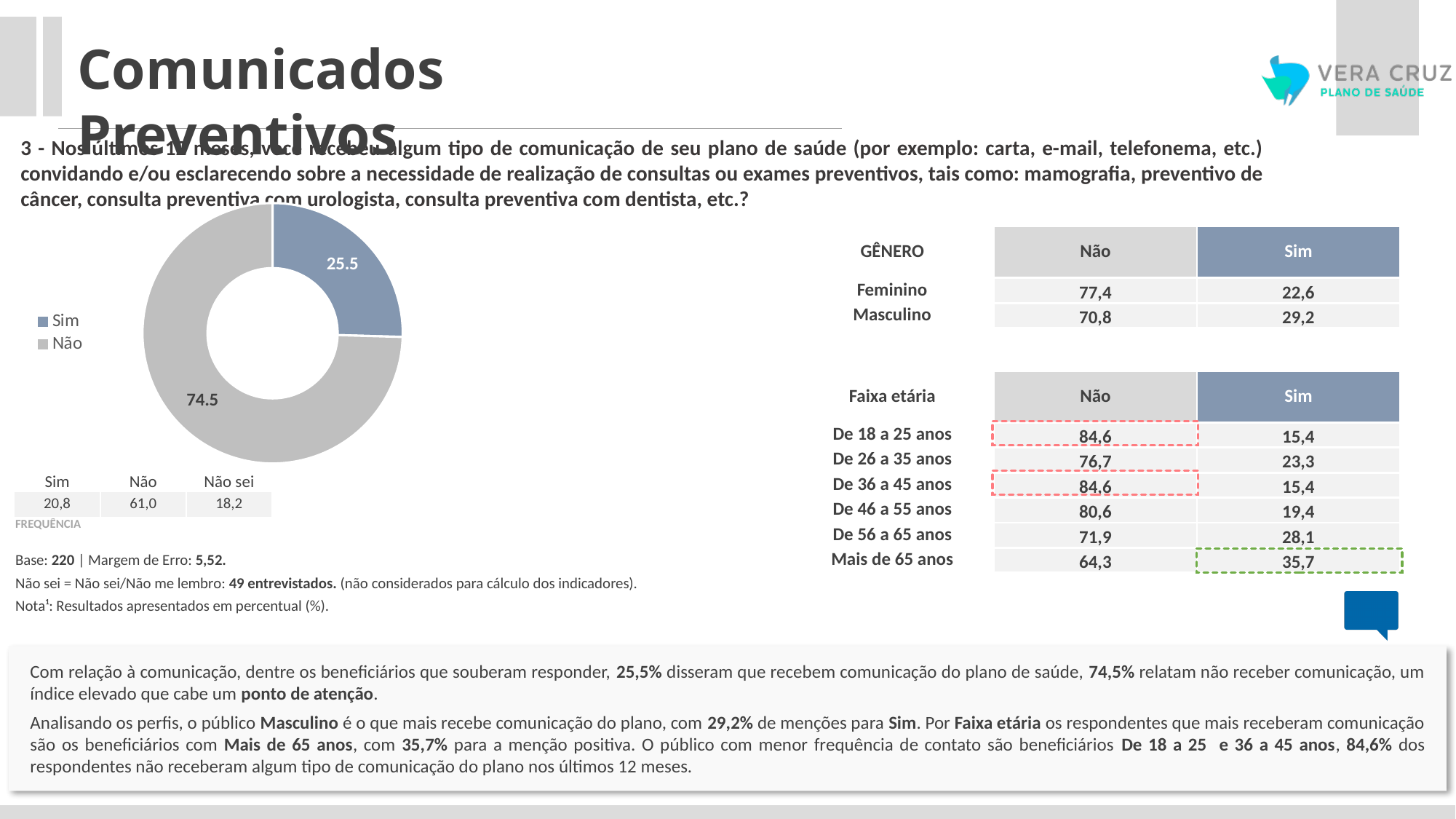
What is the total of the two values shown in the donut chart? 100 Which slice of the donut chart is the smallest? Sim What value is shown for the "Não" slice of the donut chart? 74.5 What is the difference between the "Não" and "Sim" values in the donut chart? 49 What value is shown for the "Sim" slice of the donut chart? 25.5 Which slice of the donut chart is the largest? Não What are the two legend entries of the donut chart? Sim and Não How many slices does the donut chart have? 2 What colour is the "Não" slice in the donut chart? Grey In the donut chart, which is larger: the value for "Sim" or the value for "Não"? Não What type of chart is shown on the slide? Donut chart How many entries does the legend of the donut chart list? 2